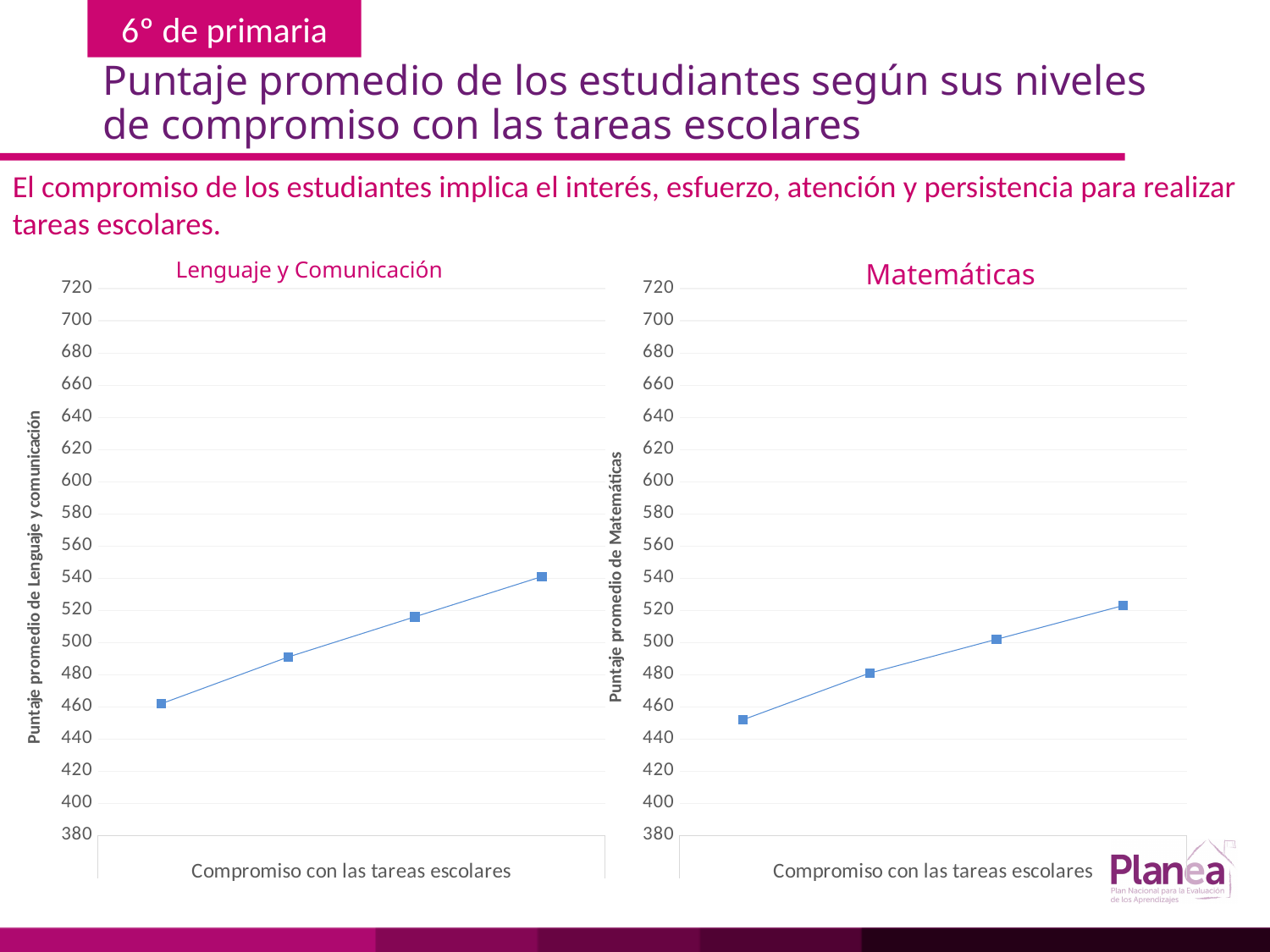
What kind of chart is the Matemáticas chart? line chart In the Lenguaje y Comunicación chart, is the value of the rightmost point greater or less than 520? greater How many data points are plotted in the Lenguaje y Comunicación chart? 4 In the Matemáticas chart, is the value of the leftmost point greater or less than 440? greater What is the x-axis title of the Matemáticas chart? Compromiso con las tareas escolares In the Lenguaje y Comunicación chart, do the values rise or fall from left to right along the x axis? rise Which chart has the higher rightmost point, Lenguaje y Comunicación or Matemáticas? Lenguaje y Comunicación What kind of chart is the Lenguaje y Comunicación chart? line chart How many data points are plotted in the Matemáticas chart? 4 In the Lenguaje y Comunicación chart, is the value of the leftmost point greater or less than 440? greater In the Matemáticas chart, do the values rise or fall from left to right along the x axis? rise